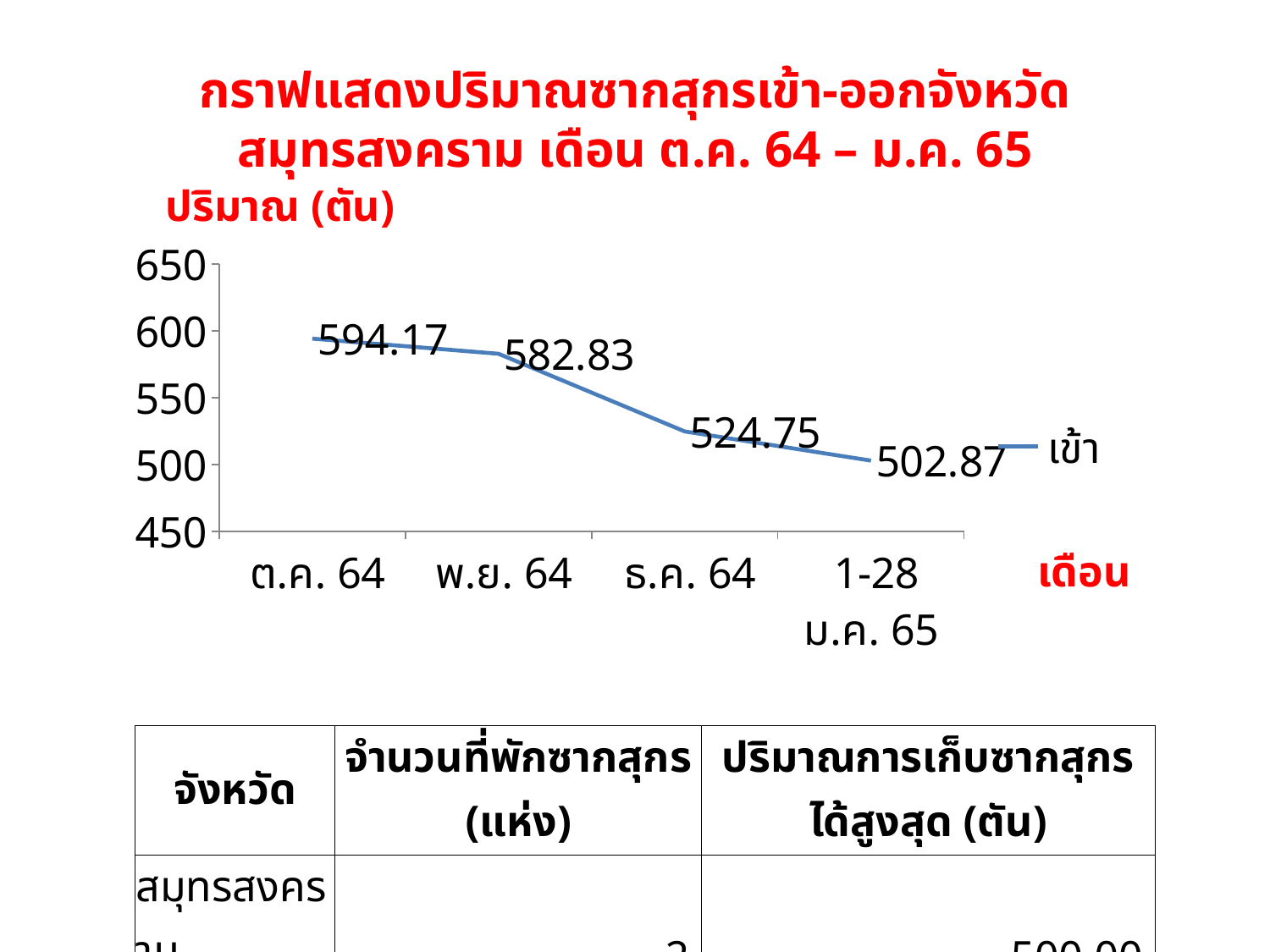
What is the value for 1-28 ม.ค. 65? 502.87 Which month has the lowest value? 1-28 ม.ค. 65 What is the difference between the values for ต.ค. 64 and 1-28 ม.ค. 65? 91.30 Do the values rise or fall from ต.ค. 64 to 1-28 ม.ค. 65? fall How many data points are plotted on the chart? 4 What is the value for ธ.ค. 64? 524.75 What is the value for ต.ค. 64? 594.17 Which is larger, the value for พ.ย. 64 or the value for ธ.ค. 64? พ.ย. 64 Which month has the highest value? ต.ค. 64 Is the value for ธ.ค. 64 greater or less than 550? less What is the value for พ.ย. 64? 582.83 What kind of chart is shown on the slide? line chart